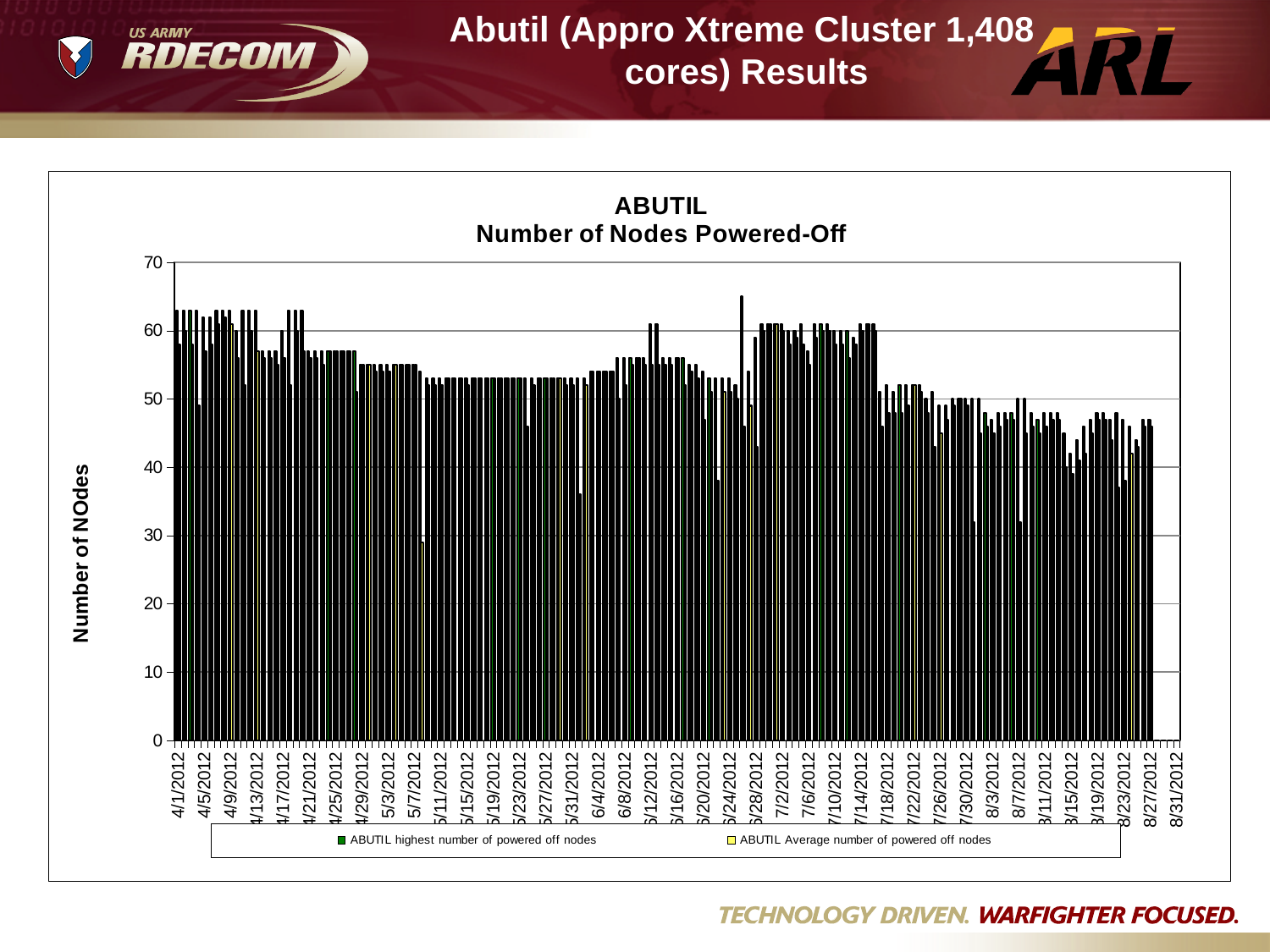
Is the highest number of powered off nodes for 4/1/2012 greater or less than 60? greater Overall, do the number of powered-off nodes rise or fall from April 2012 to August 2012? fall Is the highest number of powered off nodes for 8/27/2012 greater or less than 50? less Is the highest number of powered off nodes for 8/15/2012 greater or less than 50? less What is the title of the chart? ABUTIL Number of Nodes Powered-Off Which date has a higher number of powered off nodes, 4/1/2012 or 8/27/2012? 4/1/2012 What is the label on the vertical axis of the chart? Number of NOdes How many series does the legend list? 2 What kind of chart is shown on the slide? bar chart